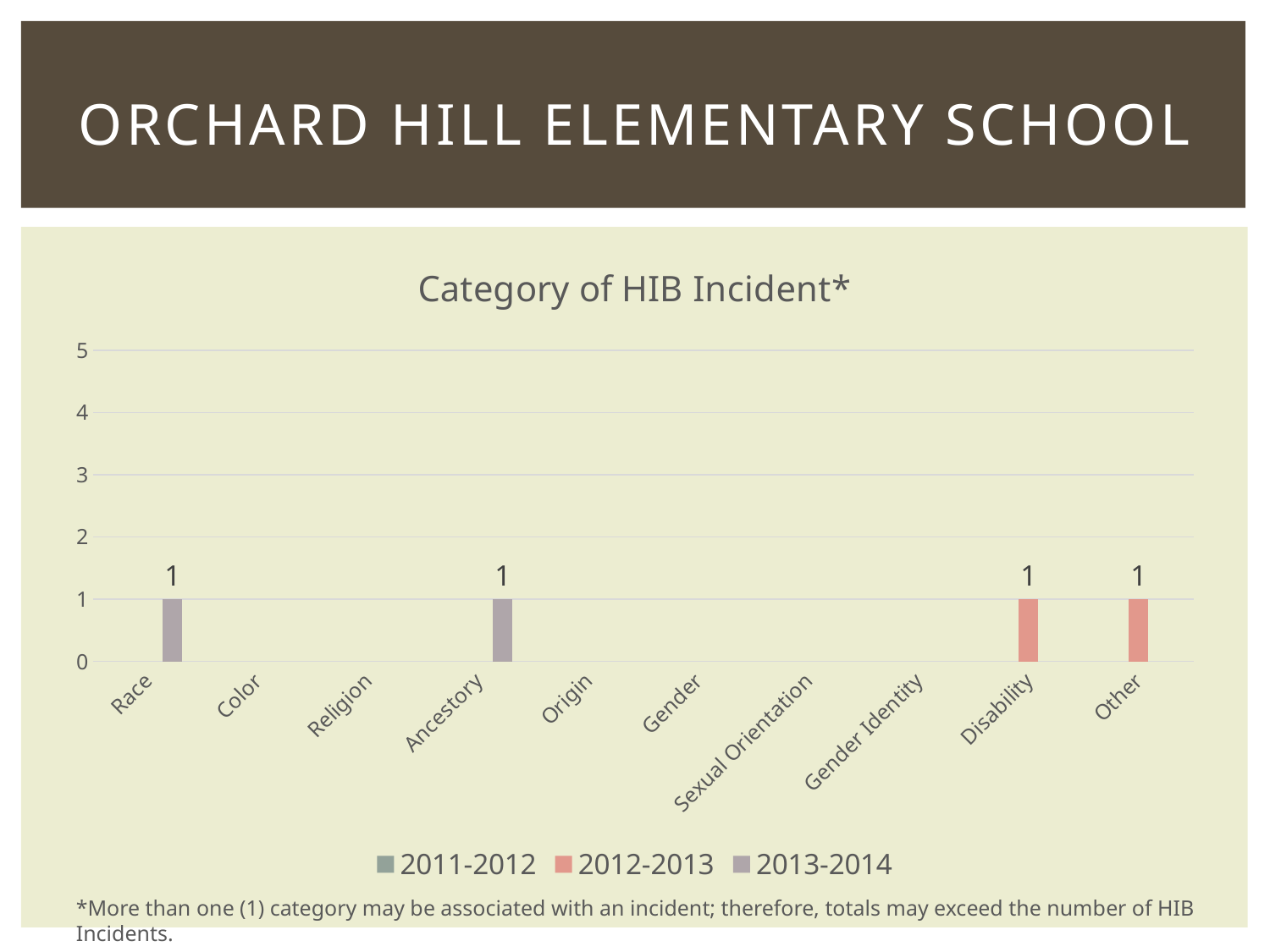
What is the value for Race in the 2013-2014 series? 1 Which series does the bar for Disability belong to? 2012-2013 What kind of chart is shown on the slide? bar chart What is the value for Ancestry in the 2013-2014 series? 1 What is the highest value shown on the vertical axis? 5 What is the title of the chart? Category of HIB Incident* How many series does the legend list? 3 How many categories are shown on the x axis? 10 Is the value for Race in the 2013-2014 series greater or less than 2? less What is the value for Other in the 2012-2013 series? 1 What is the value for Disability in the 2012-2013 series? 1 What is the difference between the value for Race (2013-2014) and the value for Other (2012-2013)? 0